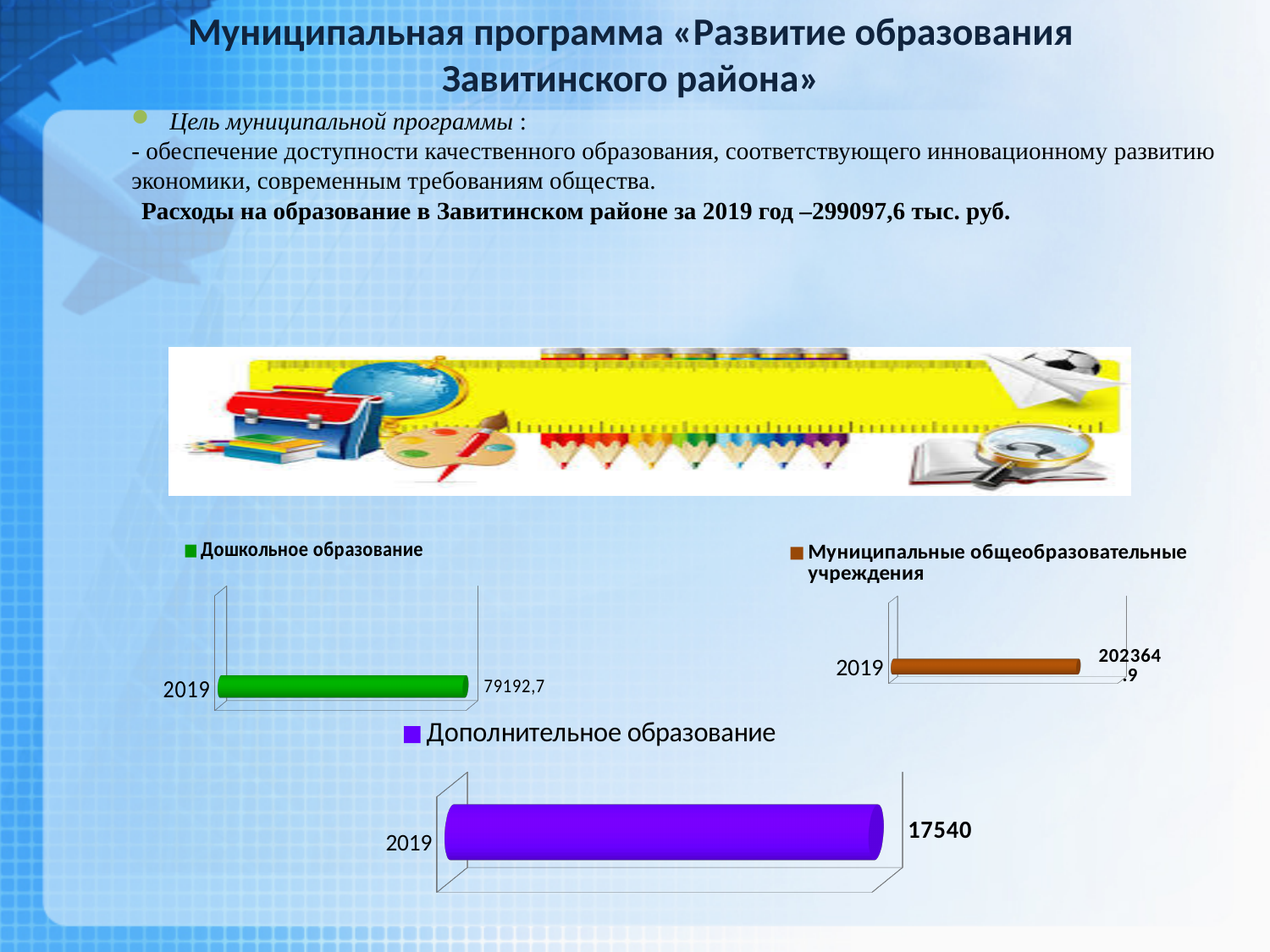
What colour is the bar in the "Дополнительное образование" chart? purple How many series does the legend of the "Муниципальные общеобразовательные учреждения" chart list? 1 In the chart with legend "Дошкольное образование", what value is labelled on the bar for 2019? 79192,7 How many charts are shown on the slide? 3 In the chart with legend "Муниципальные общеобразовательные учреждения", what value is labelled on the bar for 2019? 202364,9 What is the difference between the 2019 value in the "Дошкольное образование" chart and the 2019 value in the "Дополнительное образование" chart? 61652,7 Which is larger: the 2019 value in the "Дошкольное образование" chart or the 2019 value in the "Дополнительное образование" chart? Дошкольное образование In the chart with legend "Дополнительное образование", what value is labelled on the bar for 2019? 17540 What category label appears on the axis of the "Дополнительное образование" chart? 2019 How many categories are plotted in the "Дополнительное образование" chart? 1 What kind of chart is the "Дошкольное образование" chart? bar chart What is the difference between the 2019 value in the "Муниципальные общеобразовательные учреждения" chart and the 2019 value in the "Дошкольное образование" chart? 123172,2